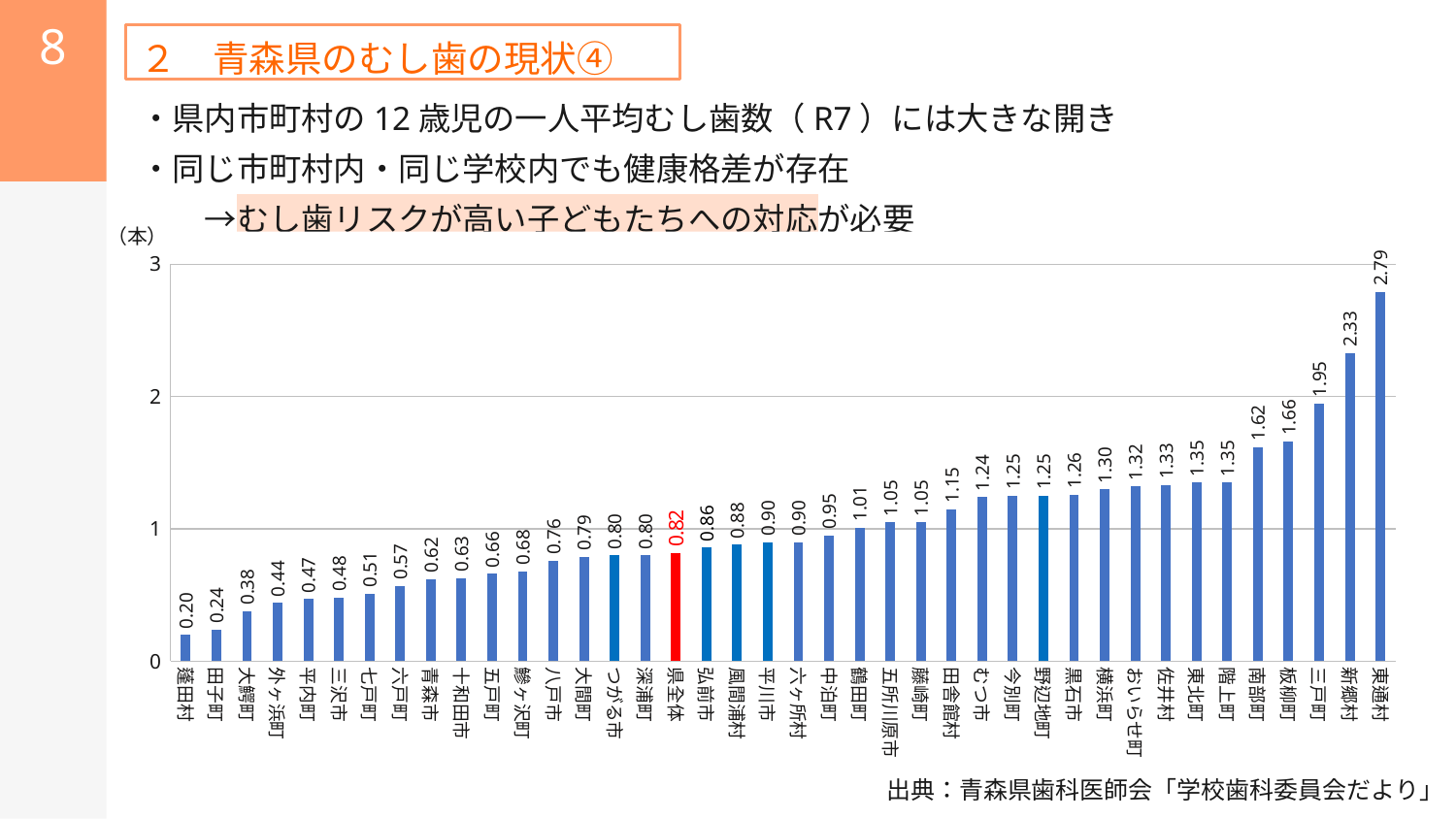
Which category has the lowest value? 蓬田村 What is the value for 県全体? 0.82 What kind of chart is shown on the slide? bar chart What is the value for 東通村? 2.79 What is the value for 三戸町? 1.95 What is the difference between the values for 新郷村 and 県全体? 1.51 Do the values rise or fall from left to right along the x axis? rise What is the value for 青森市? 0.62 Is the value for 南部町 greater or less than 1? greater Which is larger, the value for 八戸市 or the value for 弘前市? 弘前市 What is the difference between the values for 東通村 and 蓬田村? 2.59 Which category has the highest value? 東通村